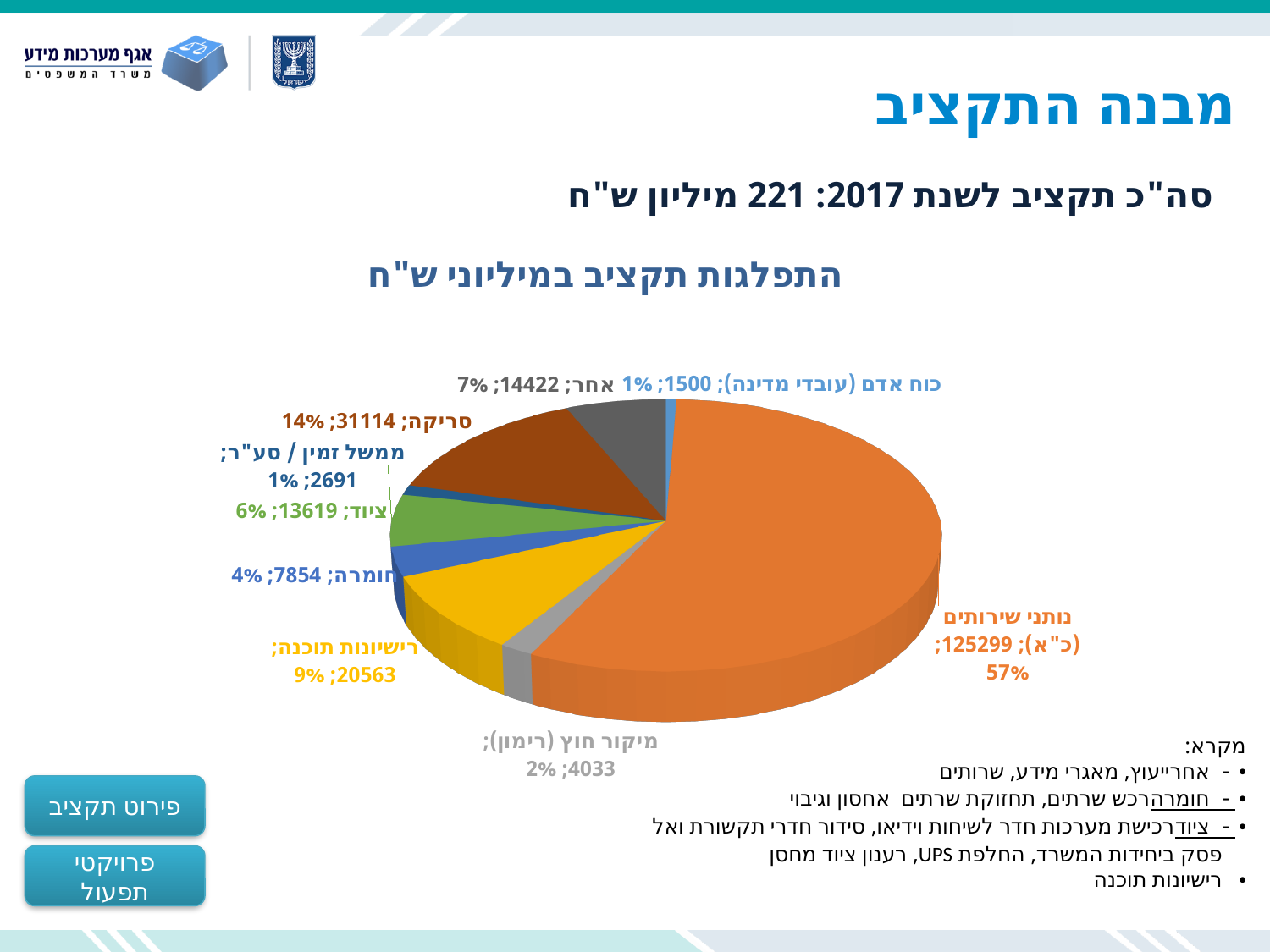
What percentage share does סריקה have in the pie chart? 14% Which category has the largest slice of the pie? נותני שירותים (כ"א) What is the difference between the values for סריקה and רישיונות תוכנה? 10551 How many slices does the pie chart have? 9 Which is larger, the value for ציוד or the value for חומרה? ציוד What is the value shown for נותני שירותים (כ"א)? 125299 What percentage share does אחר have in the pie chart? 7% What is the title of the chart? התפלגות תקציב במיליוני ש"ח What is the value shown for מיקור חוץ (רימון)? 4033 Which category has the smallest value in the pie chart? כוח אדם (עובדי מדינה) What kind of chart is shown on the slide? pie chart What is the value shown for רישיונות תוכנה? 20563